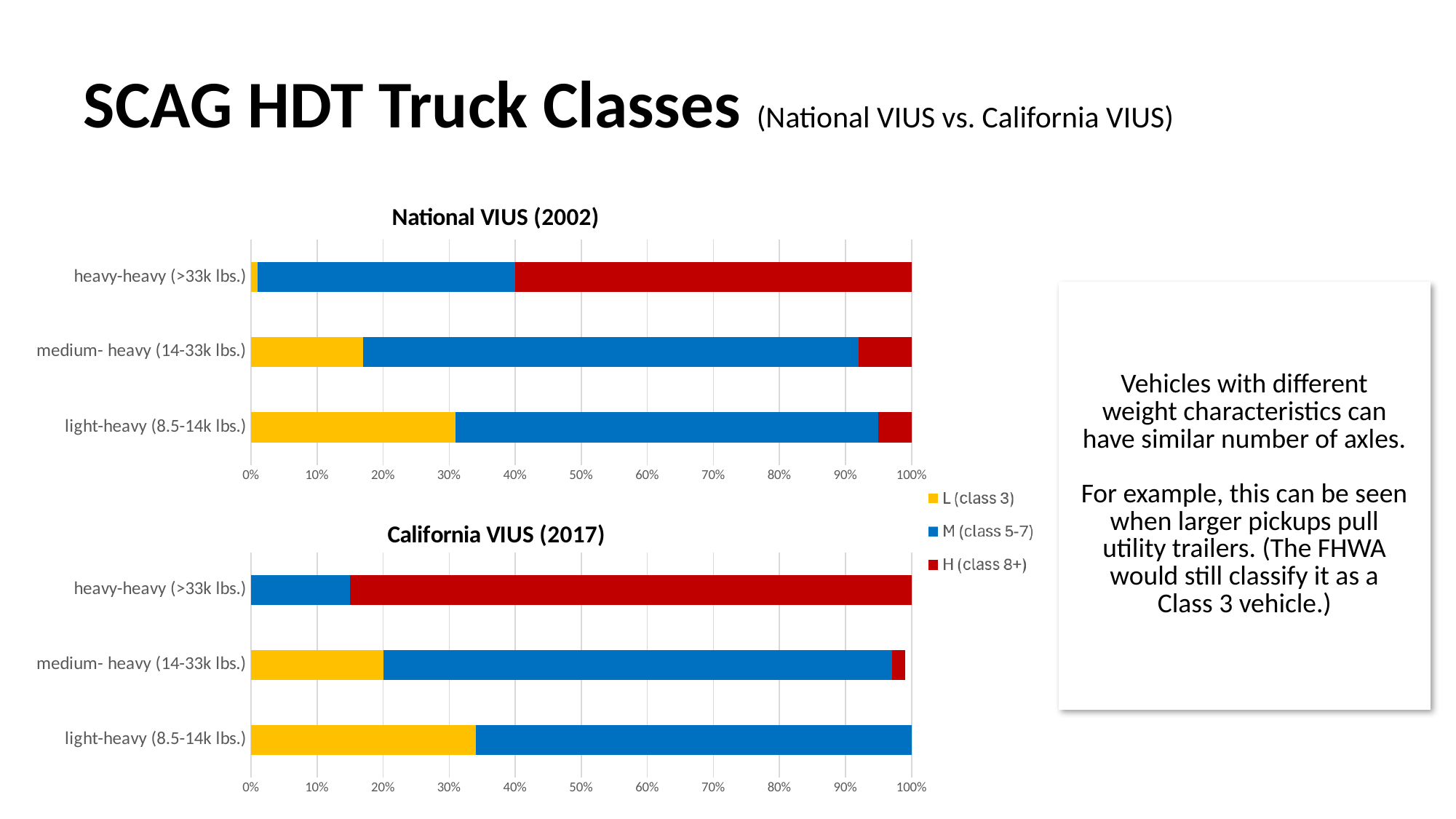
How many series does the legend list? 3 Which series is shown in red in the legend? H (class 8+) How many truck weight categories are shown in the California VIUS (2017) chart? 3 Which chart shows a larger H (class 8+) share for heavy-heavy (>33k lbs.), National VIUS (2002) or California VIUS (2017)? California VIUS (2017) What is the title of the lower chart? California VIUS (2017) In the California VIUS (2017) chart, is the M (class 5-7) share for heavy-heavy (>33k lbs.) greater or less than 20%? less In the National VIUS (2002) chart, which category has the largest L (class 3) share? light-heavy (8.5-14k lbs.) In the National VIUS (2002) chart, is the H (class 8+) share for heavy-heavy (>33k lbs.) greater or less than 50%? greater In the California VIUS (2017) chart, which category has the largest H (class 8+) share? heavy-heavy (>33k lbs.) In the California VIUS (2017) chart, is the H (class 8+) share for heavy-heavy (>33k lbs.) greater or less than 80%? greater What kind of chart is the National VIUS (2002) chart? Stacked bar chart